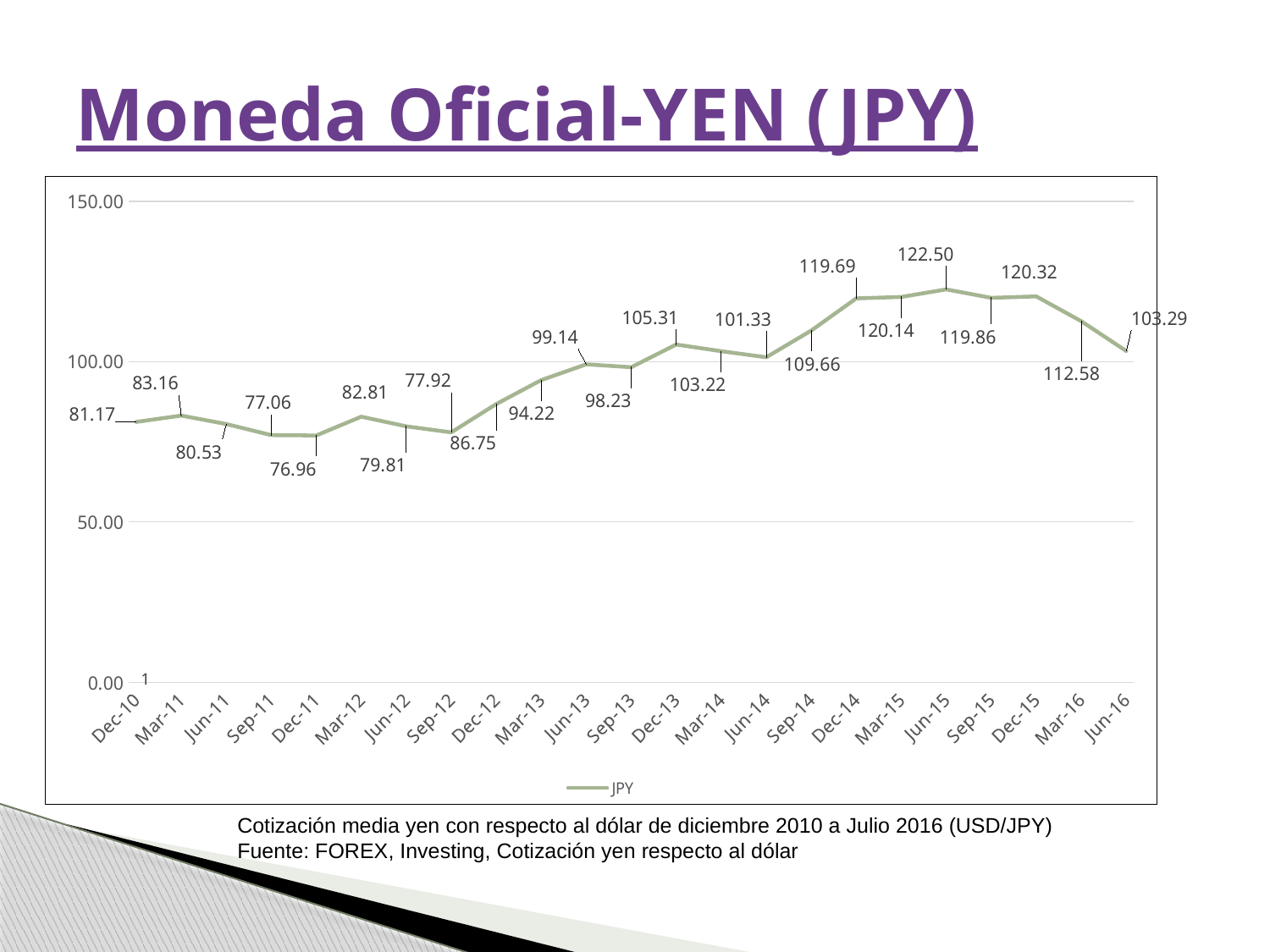
What is the JPY value for Jun-16? 103.29 Does the JPY line generally rise or fall from Dec-10 to Jun-15? rise What is the JPY value for Sep-14? 109.66 What is the JPY value for Dec-10? 81.17 In which period does the JPY line reach its highest value? Jun-15 What type of chart is shown on the slide? line chart What is the JPY value for Jun-15? 122.50 What is the difference between the JPY values for Jun-15 and Dec-11? 45.54 Which is larger, the JPY value for Dec-13 or for Mar-14? Dec-13 How many data points are plotted on the JPY line? 23 In which period does the JPY line reach its lowest value? Dec-11 How many series does the legend list? 1